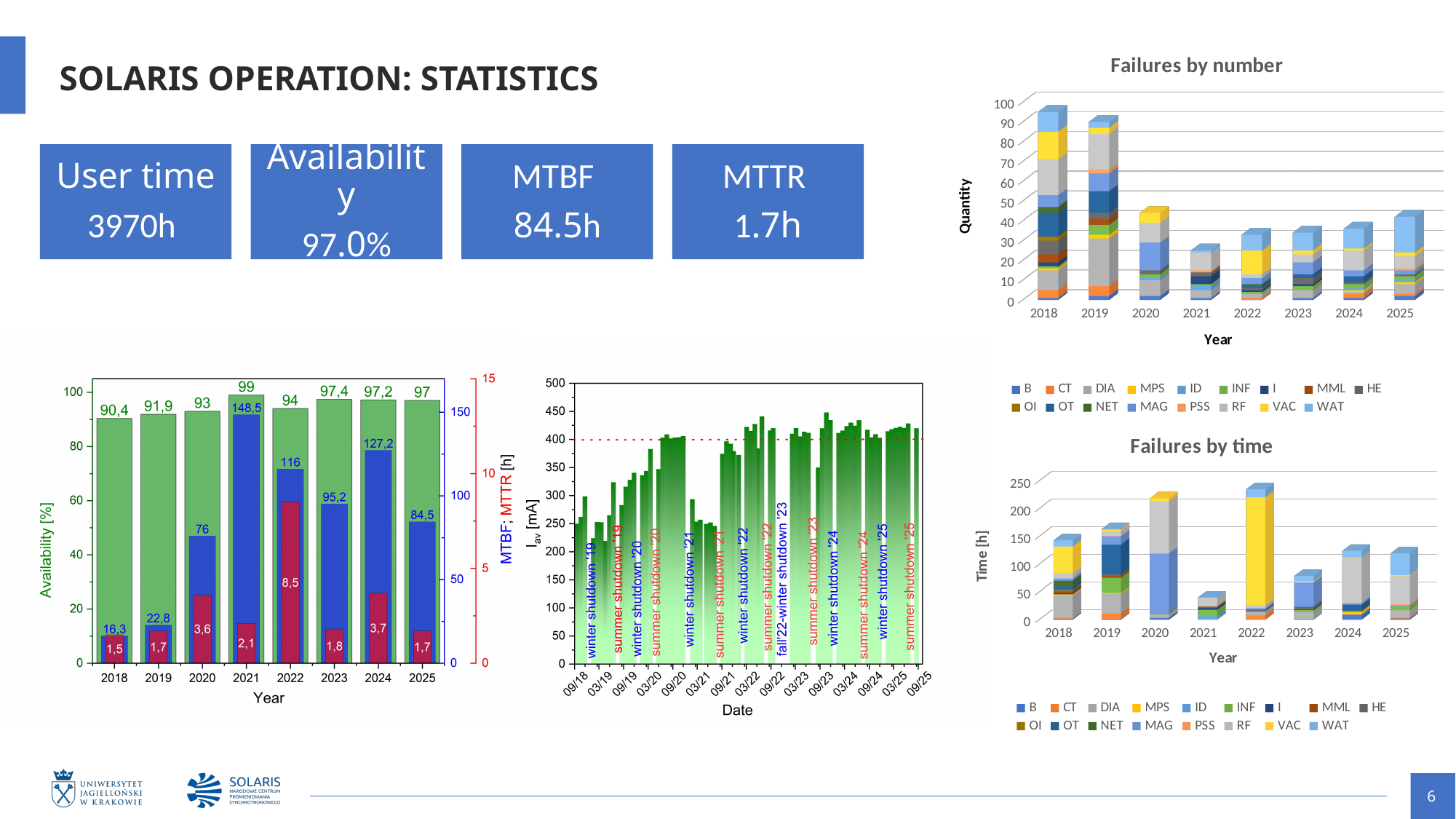
How many series does the legend of the 'Failures by time' chart list? 17 In the bottom-left availability chart, how many years are shown on the x axis? 8 In the bottom-left availability chart, what is the difference between the availability in 2021 and in 2018? 8,6 In the 'Failures by number' chart, which year has the lowest total number of failures? 2021 In the bottom-left availability chart, what is the availability value shown for 2021? 99 What kind of chart is the 'Failures by number' chart? bar chart In the 'Failures by number' chart, is the total for 2021 greater or less than 30? less In the bottom-left availability chart, which year has the highest MTBF? 2021 In the bottom-left availability chart, what is the MTBF value shown for 2025? 84,5 In the bottom-left availability chart, which year has the highest MTTR? 2022 In the 'Failures by time' chart, is the total for 2020 greater or less than 200? greater In the bottom-left availability chart, which year has the lowest availability? 2018